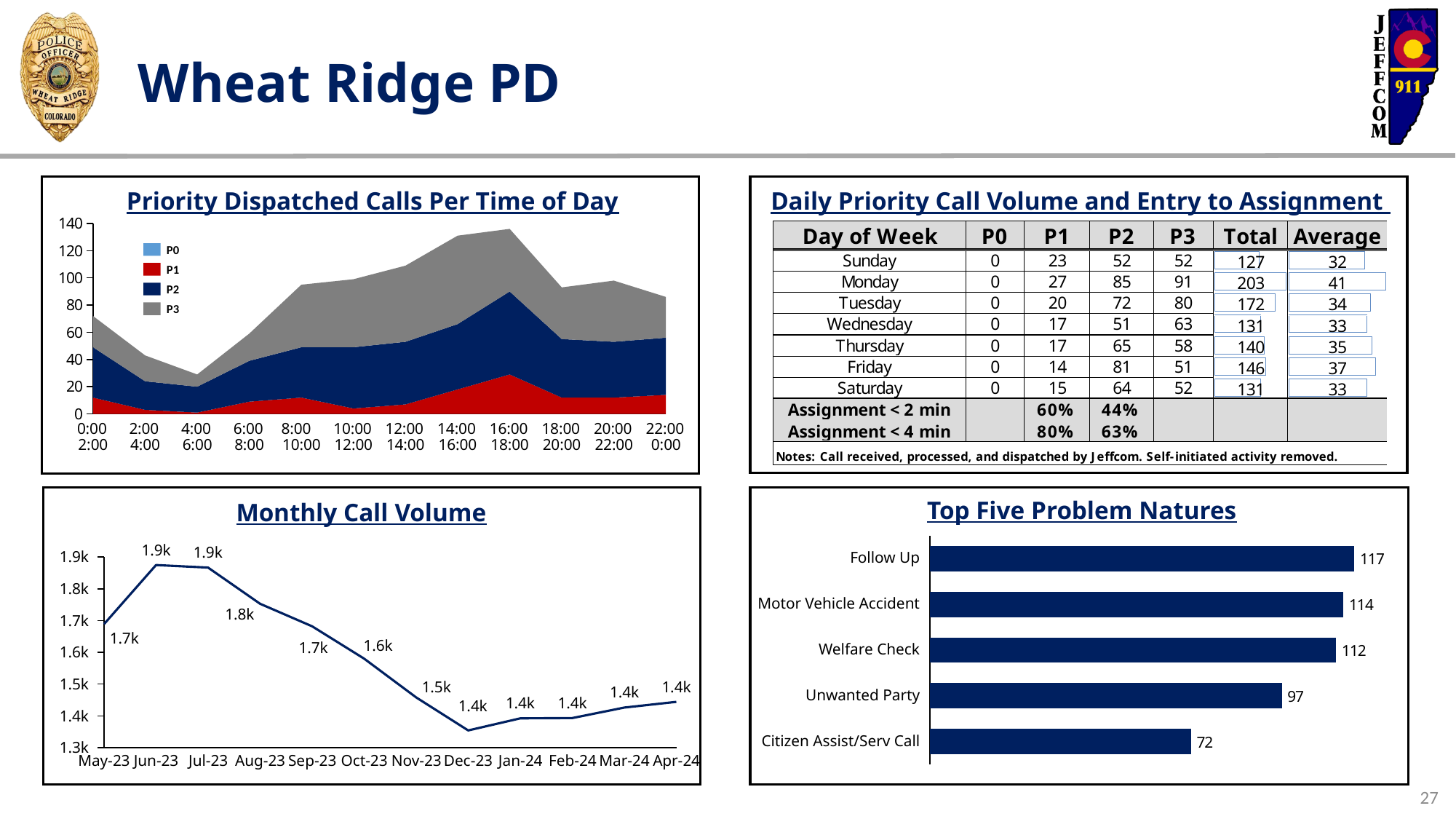
In the Top Five Problem Natures chart, which problem nature has the lowest value? Citizen Assist/Serv Call In the Monthly Call Volume chart, what is the value for May-23? 1.7k In the Top Five Problem Natures chart, which is larger, Welfare Check or Unwanted Party? Welfare Check In the Monthly Call Volume chart, do values rise or fall from Jul-23 to Dec-23? Fall In the Monthly Call Volume chart, what is the value for Dec-23? 1.4k What kind of chart is the Top Five Problem Natures chart? Bar chart How many months are plotted in the Monthly Call Volume chart? 12 In the Top Five Problem Natures chart, what is the value for Unwanted Party? 97 In the Top Five Problem Natures chart, what is the difference between Follow Up and Citizen Assist/Serv Call? 45 In the Top Five Problem Natures chart, what is the value for Follow Up? 117 How many series does the legend of the Priority Dispatched Calls Per Time of Day chart list? 4 In the Priority Dispatched Calls Per Time of Day chart, is the total stacked value for 16:00-18:00 greater or less than 120? greater